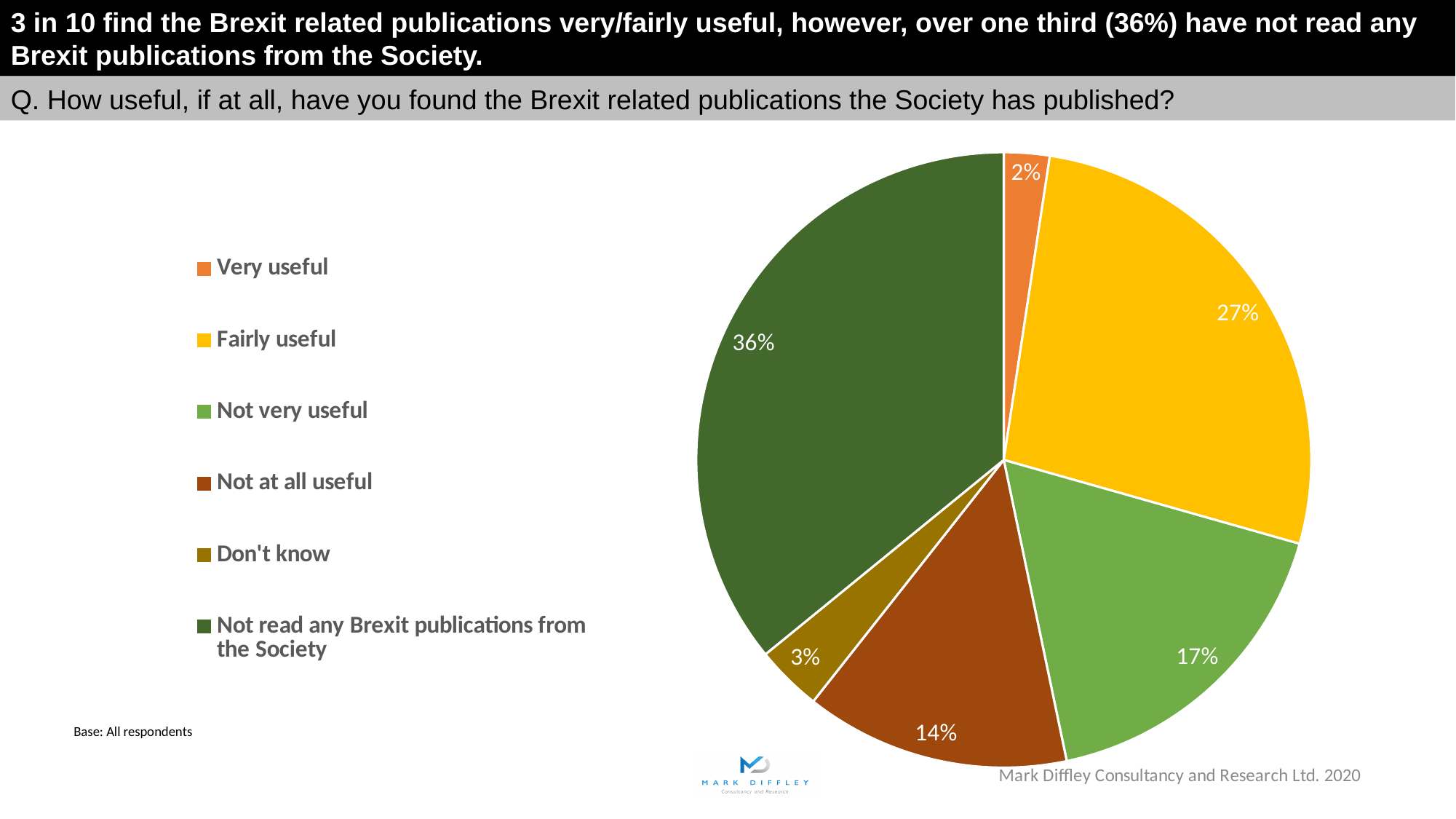
What percentage of respondents found the Brexit related publications fairly useful? 27% Which category has the largest share of the pie? Not read any Brexit publications from the Society What is the combined percentage for 'Very useful' and 'Fairly useful'? 29% What kind of chart is shown on the slide? Pie chart What percentage of respondents said they had not read any Brexit publications from the Society? 36% Which is larger: the share for 'Not at all useful' or the share for 'Not very useful'? Not very useful What colour is the slice for 'Not at all useful'? Brown What percentage of respondents found the publications not very useful? 17% What is the difference in percentage points between 'Fairly useful' and 'Not very useful'? 10 How many categories does the legend list? 6 What percentage of respondents answered 'Don't know'? 3% Which category has the smallest share of the pie? Very useful